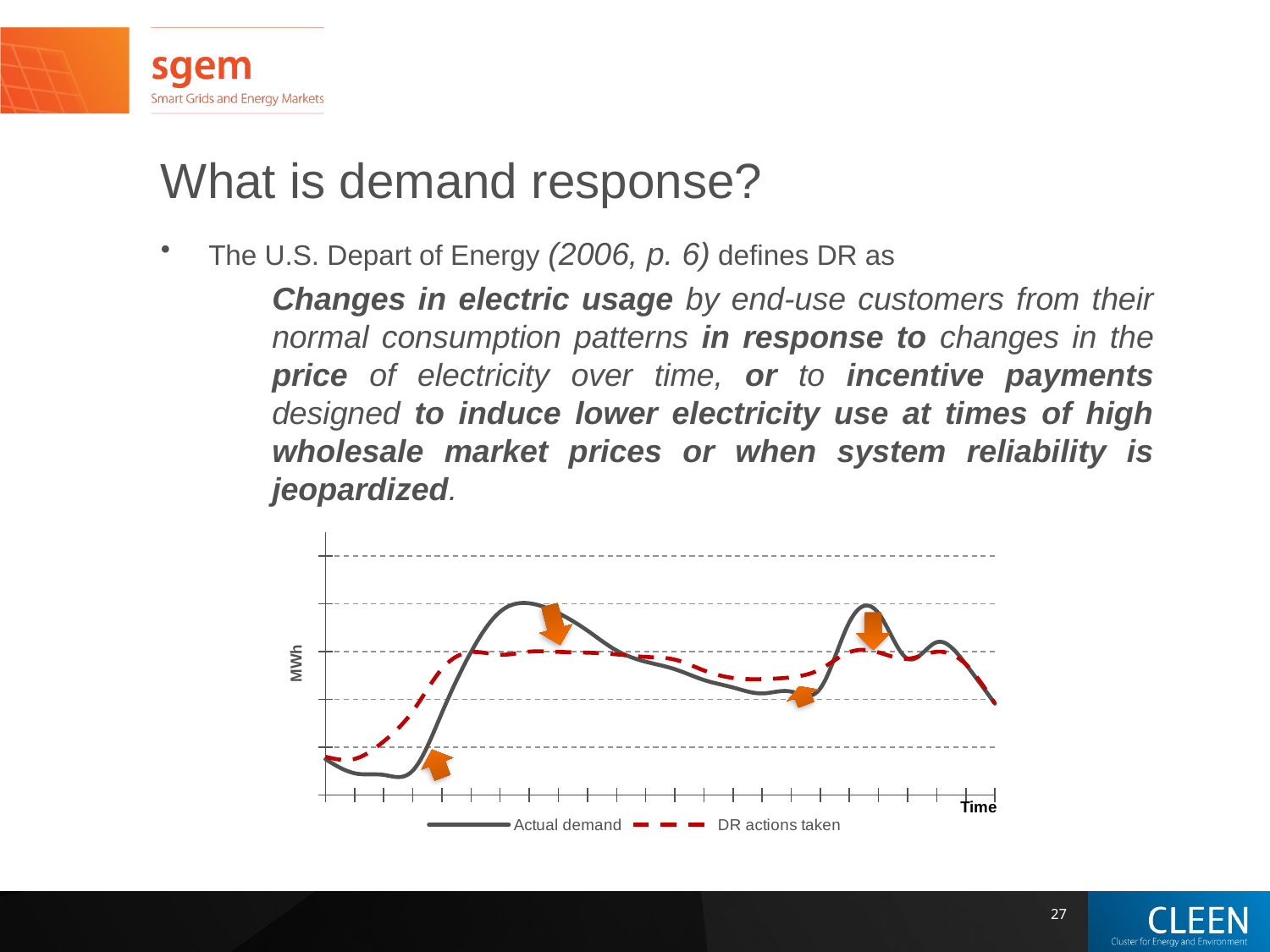
At the first large peak of the actual demand line, which series is higher: Actual demand or DR actions taken? Actual demand How many series does the chart's legend list? 2 At the far left start of the chart, which series is higher: Actual demand or DR actions taken? DR actions taken What kind of chart is shown on the slide? Line chart Which series shows the larger swings between its peaks and dips: Actual demand or DR actions taken? Actual demand Does the DR actions taken line rise or fall from the start of the chart up to the first peak of actual demand? Rise What are the two series named in the chart's legend? Actual demand and DR actions taken Which series is drawn as a red dashed line? DR actions taken What is the label on the chart's vertical axis? MWh Does the actual demand line rise or fall at the far right end of the chart? Fall